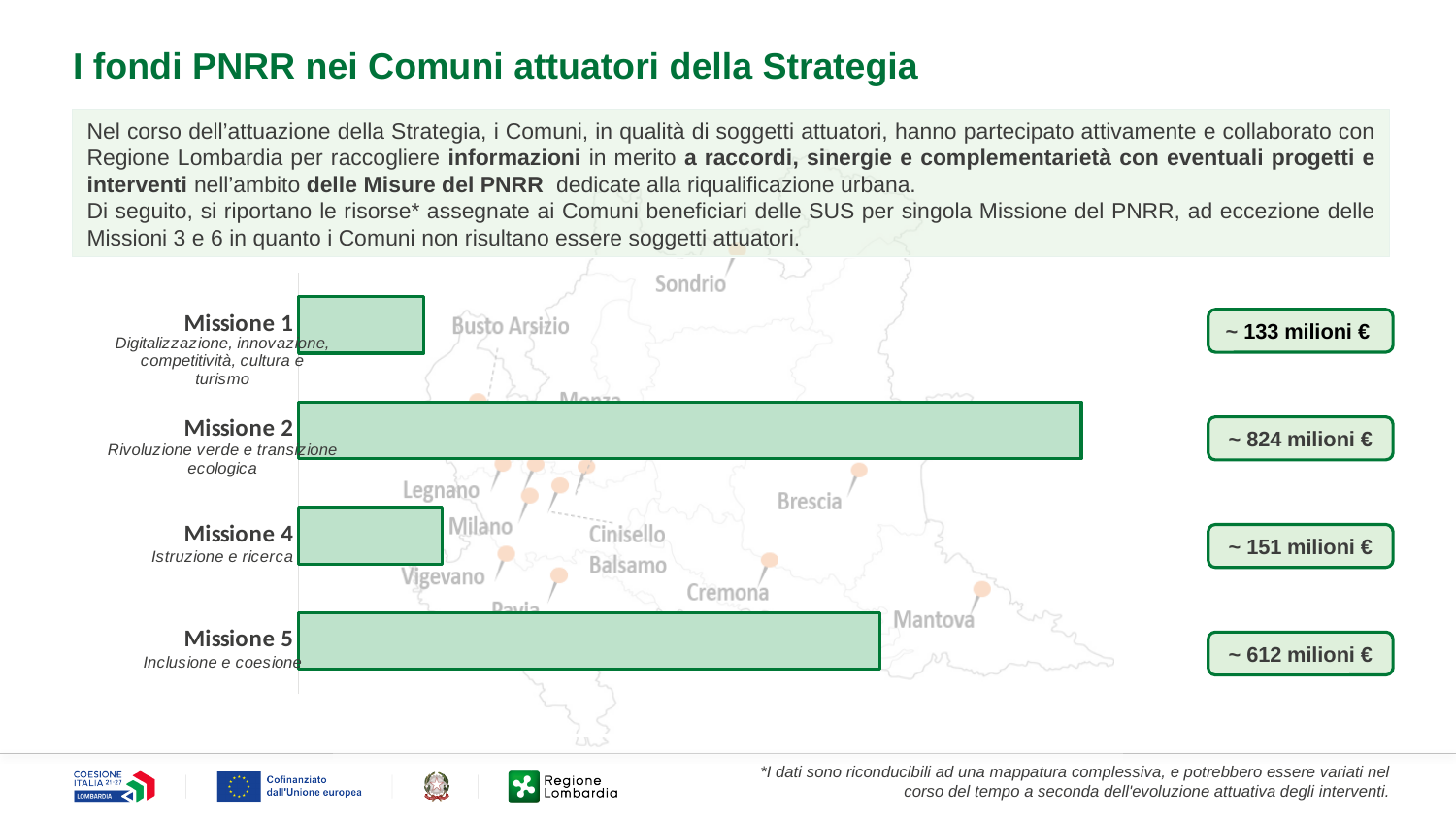
What value is shown for Missione 2? ~ 824 milioni € What is the subtitle shown under Missione 4 in the chart? Istruzione e ricerca What value is shown for Missione 4? ~ 151 milioni € Which has a larger value, Missione 1 or Missione 2? Missione 2 Which mission has the highest value in the chart? Missione 2 Which has a larger value, Missione 5 or Missione 4? Missione 5 What is the title of the slide containing the chart? I fondi PNRR nei Comuni attuatori della Strategia What kind of chart is shown on the slide? bar chart What value is shown for Missione 5? ~ 612 milioni € How many missions (categories) are plotted in the chart? 4 Which mission has the lowest value in the chart? Missione 1 What value is shown for Missione 1? ~ 133 milioni €